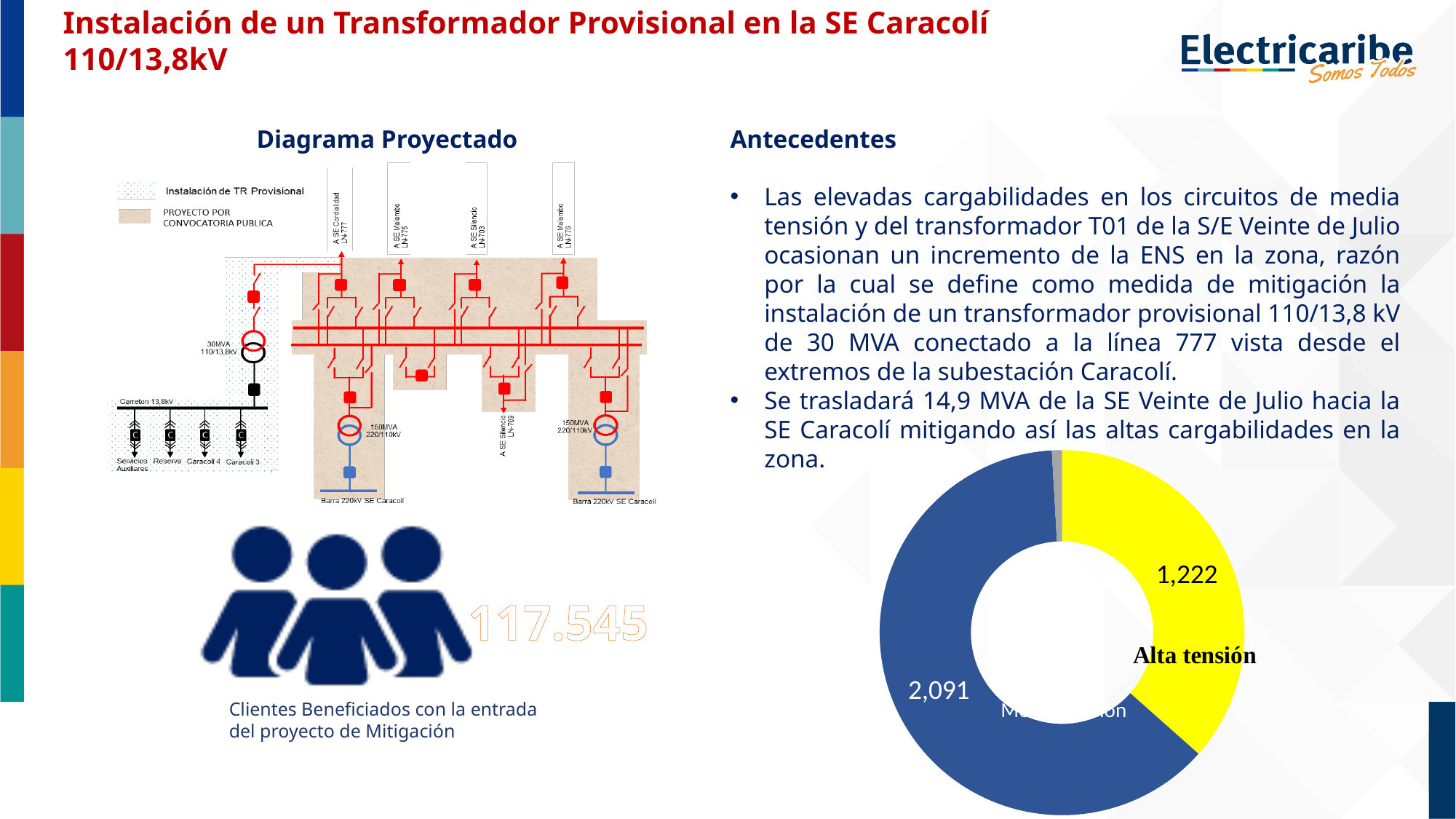
What kind of chart is shown at the bottom right of the slide? Doughnut (pie) chart How many data values are printed on the doughnut chart? 2 In the doughnut chart, is the value for Alta tensión greater or less than 2,000? less In the doughnut chart, which slice has the largest value? The blue slice (2,091) In the doughnut chart, what is the difference between the blue slice value (2,091) and the Alta tensión value (1,222)? 869 What colour is the Alta tensión slice in the doughnut chart? Yellow In the doughnut chart, what value is shown for Alta tensión? 1,222 In the doughnut chart, which labeled slice has the smallest printed value? Alta tensión In the doughnut chart, what value is shown on the blue slice? 2,091 In the doughnut chart, which slice is larger: the yellow Alta tensión slice or the blue slice? The blue slice